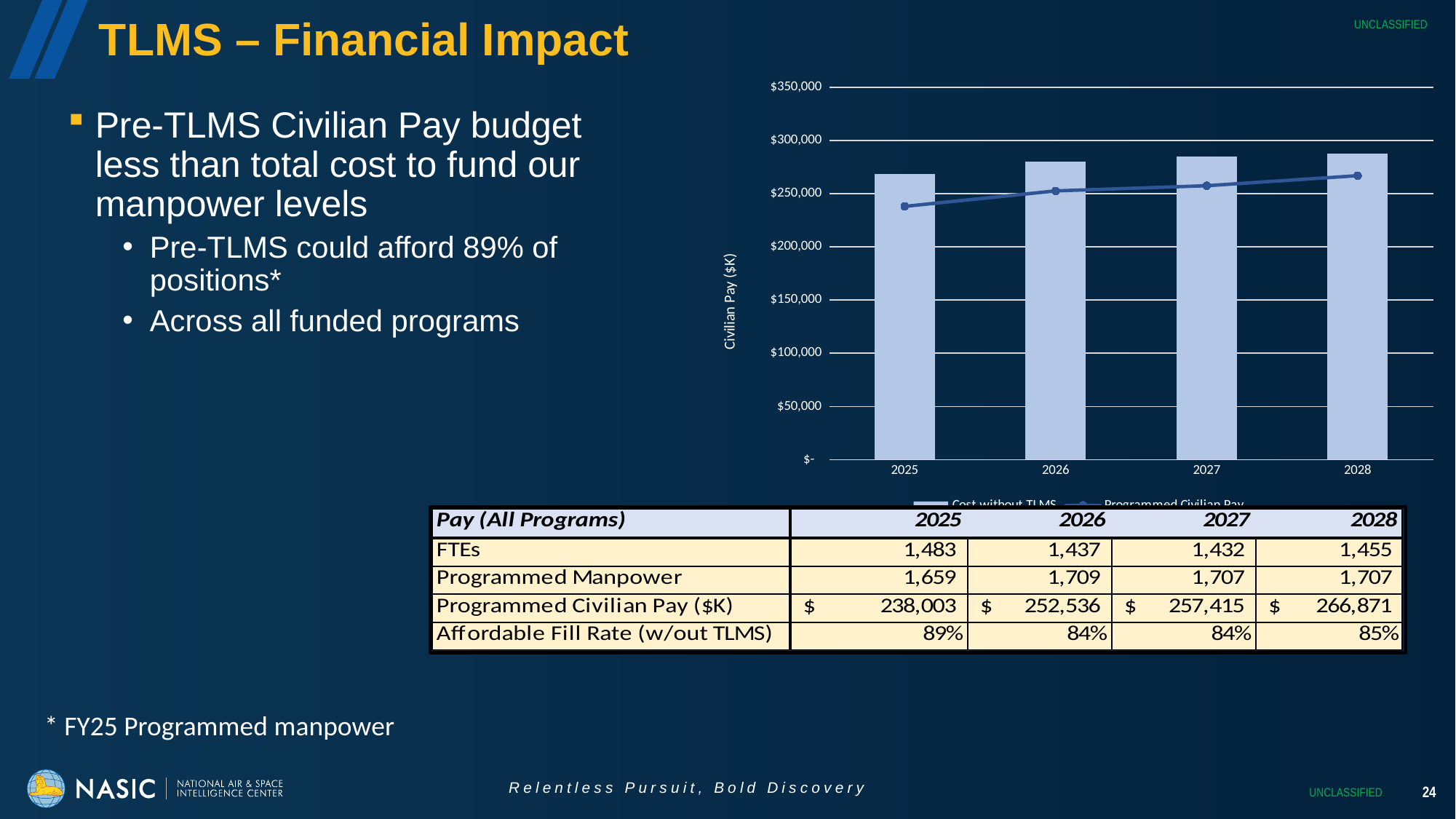
Which year has the shortest 'Cost without TLMS' bar? 2025 What kind of chart is shown on the slide? A bar chart with a line series How many years are shown on the x axis of the chart? 4 Is the 'Cost without TLMS' bar for 2028 greater or less than $300,000? less Do the 'Cost without TLMS' bars rise or fall from 2025 to 2028? Rise Which year has the tallest 'Cost without TLMS' bar? 2028 How many series does the chart's legend list? 2 What is the label on the chart's vertical axis? Civilian Pay ($K) According to the table below the chart, what is the Programmed Civilian Pay ($K) plotted for 2028? $ 266,871 Is the 'Programmed Civilian Pay' point for 2025 greater or less than $250,000? less Which is larger in 2027, the 'Cost without TLMS' bar or the 'Programmed Civilian Pay' point? Cost without TLMS Is the 'Cost without TLMS' bar for 2025 greater or less than $250,000? greater